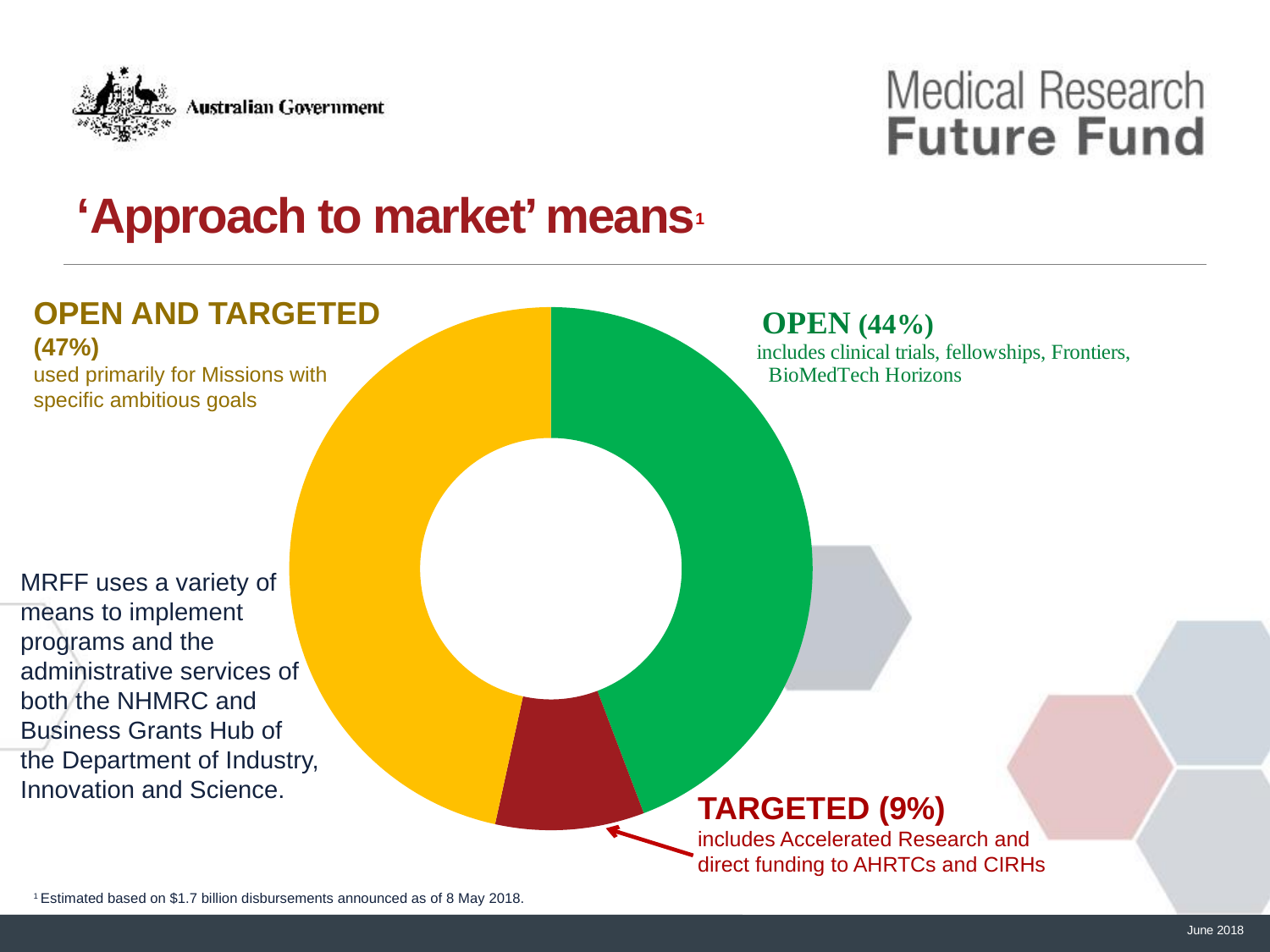
How many segments does the chart have? 3 What kind of chart is shown on the slide? Pie chart (donut) What share of the chart is labelled TARGETED? 9% What share of the chart is labelled OPEN? 44% What share of the chart is labelled OPEN AND TARGETED? 47% What colour is the OPEN segment? Green Which segment has the smallest share? TARGETED What is the difference in percentage points between the OPEN AND TARGETED share and the OPEN share? 3 What colour is the TARGETED segment? Dark red Which is larger, the OPEN share or the TARGETED share? OPEN What is the difference in percentage points between the OPEN AND TARGETED share and the TARGETED share? 38 Which segment has the largest share? OPEN AND TARGETED